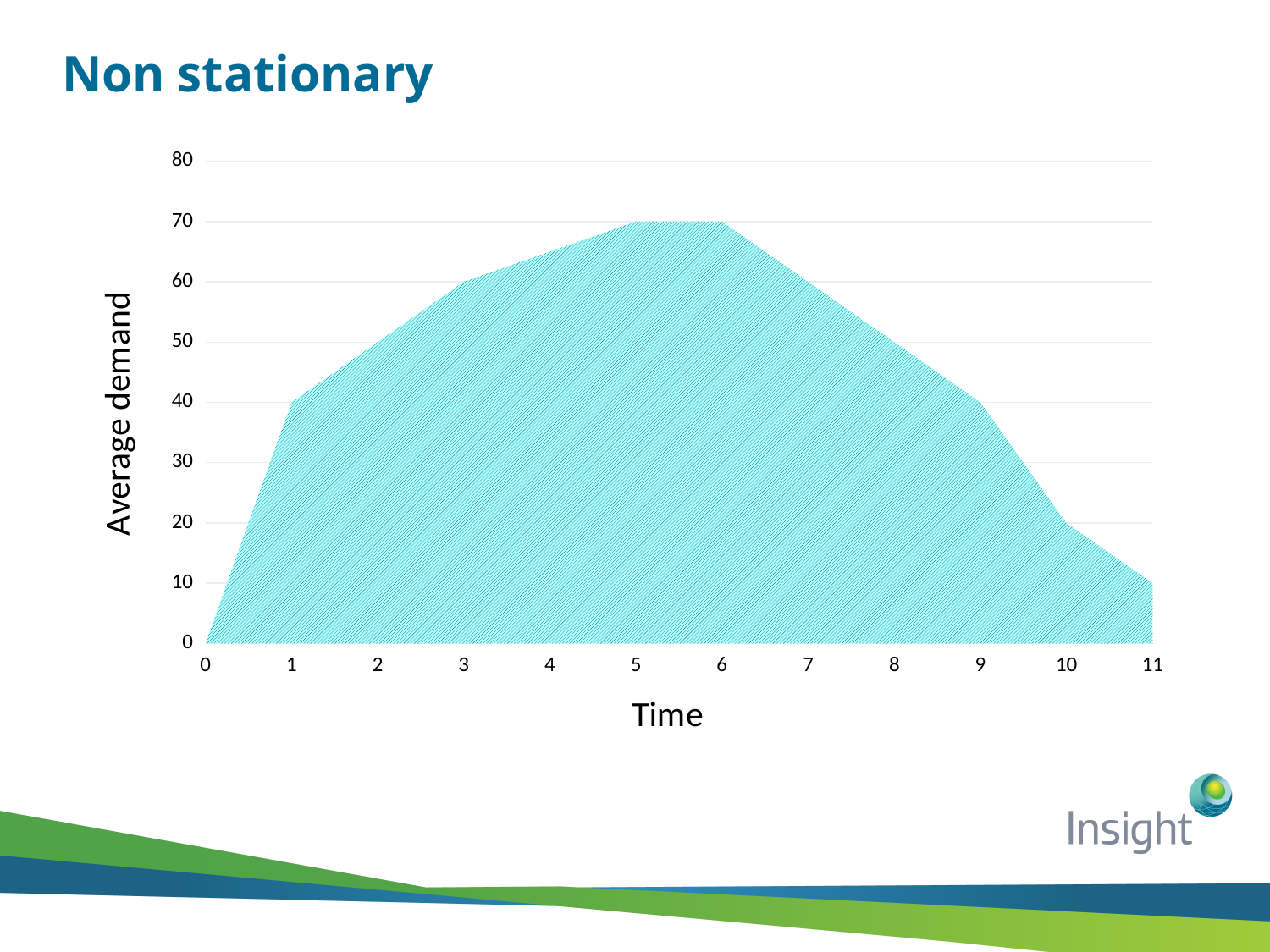
What kind of chart is shown on the slide? area chart What is the average demand at time 11? 10 What is the label of the y axis? Average demand Does the average demand rise or fall between time 6 and time 11? fall Is the average demand at time 4 greater or less than 60? greater Which is larger, the average demand at time 3 or at time 9? time 3 Is the average demand at time 8 greater or less than 40? greater What is the average demand at time 10? 20 What is the label of the x axis? Time What is the highest value of average demand reached on the chart? 70 What is the average demand at time 5? 70 What is the average demand at time 1? 40